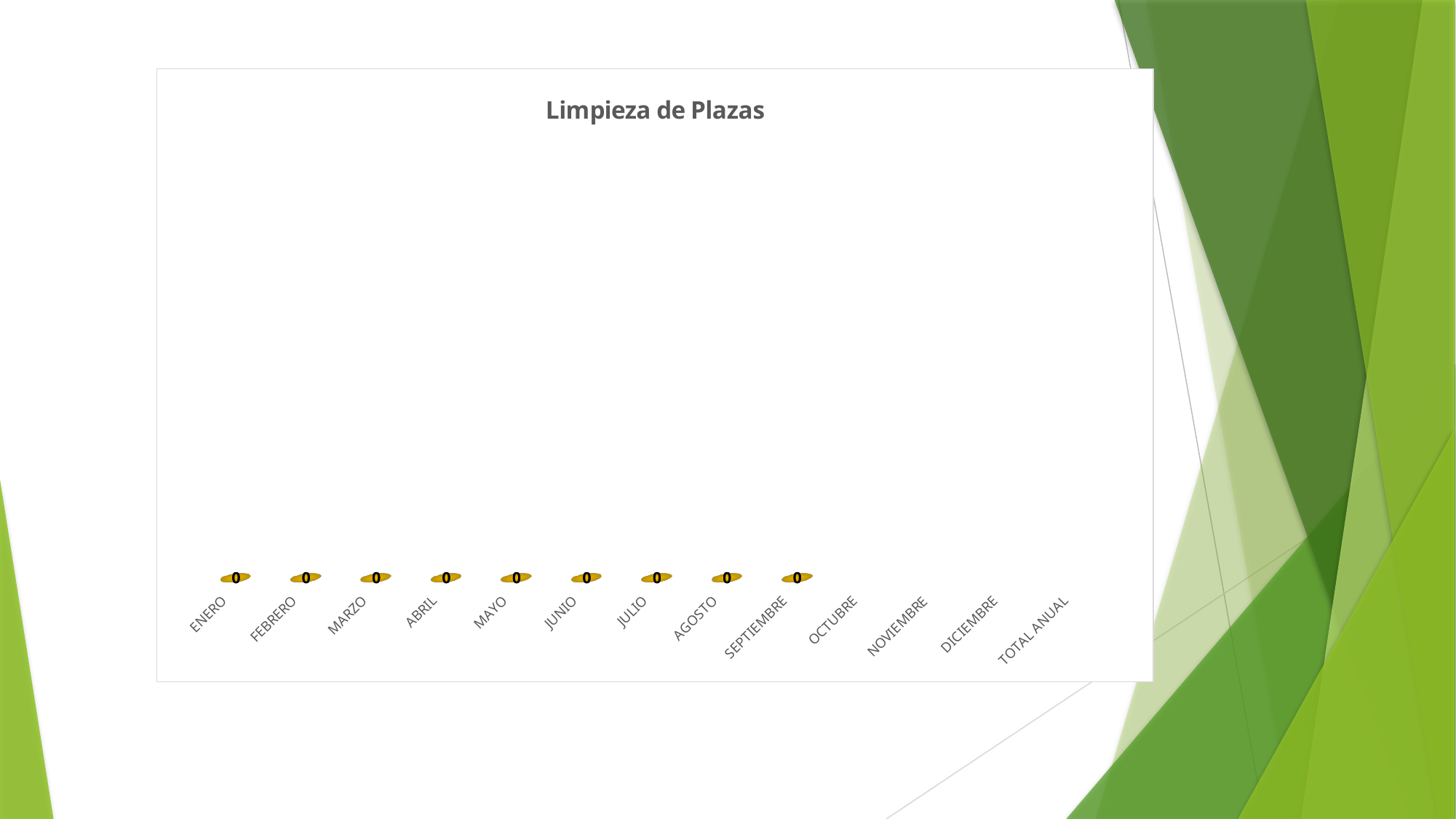
Do the values rise, fall, or stay the same from ENERO to SEPTIEMBRE? stay the same What is the value shown for AGOSTO? 0 What is the difference between the values for ENERO and MAYO? 0 What is the title of the chart? Limpieza de Plazas How many categories are listed along the x axis? 13 What is the value shown for JUNIO? 0 What kind of chart is shown? bar chart What is the value shown for ENERO? 0 What is the value shown for MARZO? 0 What is the value shown for SEPTIEMBRE? 0 How many categories have a data label of 0 displayed? 9 What is the label of the last category on the x axis? TOTAL ANUAL